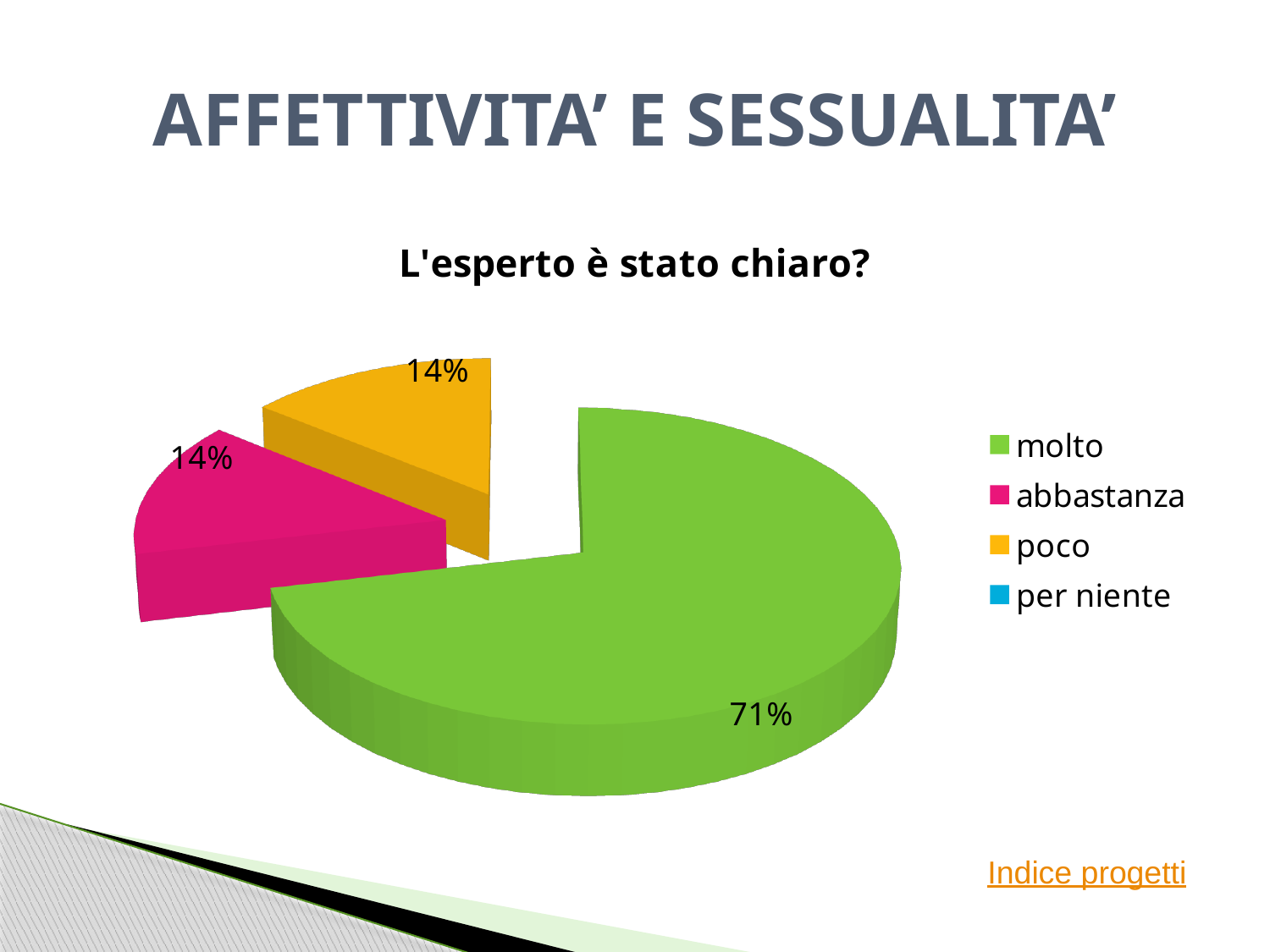
What colour is the "molto" slice? green Which category has the largest slice of the pie? molto How many entries does the legend list? 4 What kind of chart is shown on the slide? pie chart What percentage of the pie is labelled for "molto"? 71% What percentage of the pie is labelled for "abbastanza"? 14% Which slice is larger, "molto" or "abbastanza"? molto What is the difference in percentage points between the "molto" slice and the "poco" slice? 57 What is the combined share of the "abbastanza" and "poco" slices? 28% What is the title of the pie chart? L'esperto è stato chiaro? What percentage of the pie is labelled for "poco"? 14% How many slices are visible in the pie chart? 3